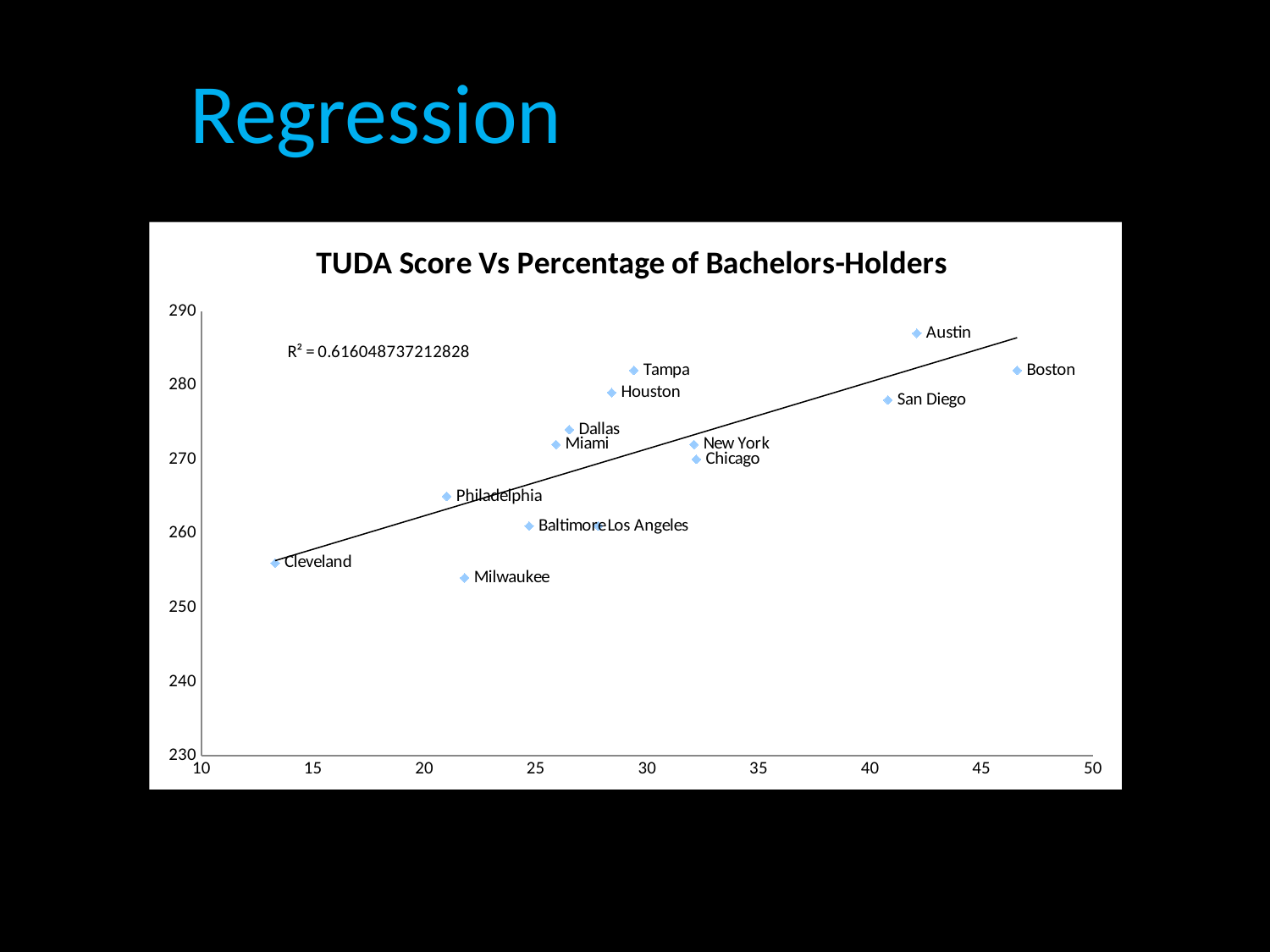
Does the trend line show TUDA scores rising or falling as the percentage of bachelors-holders increases? rising Which city has a higher TUDA score, Austin or Boston? Austin What R² value is printed on the chart? R² = 0.616048737212828 Which city has the highest TUDA score? Austin Which city has the lowest TUDA score? Milwaukee What kind of chart is shown on the slide? scatter plot Is the TUDA score for Austin greater or less than 280? greater What is the title of the chart? TUDA Score Vs Percentage of Bachelors-Holders How many cities are plotted on the chart? 14 Which city has the lowest percentage of bachelors-holders? Cleveland Is the TUDA score for Milwaukee greater or less than 260? less Which city has the highest percentage of bachelors-holders? Boston